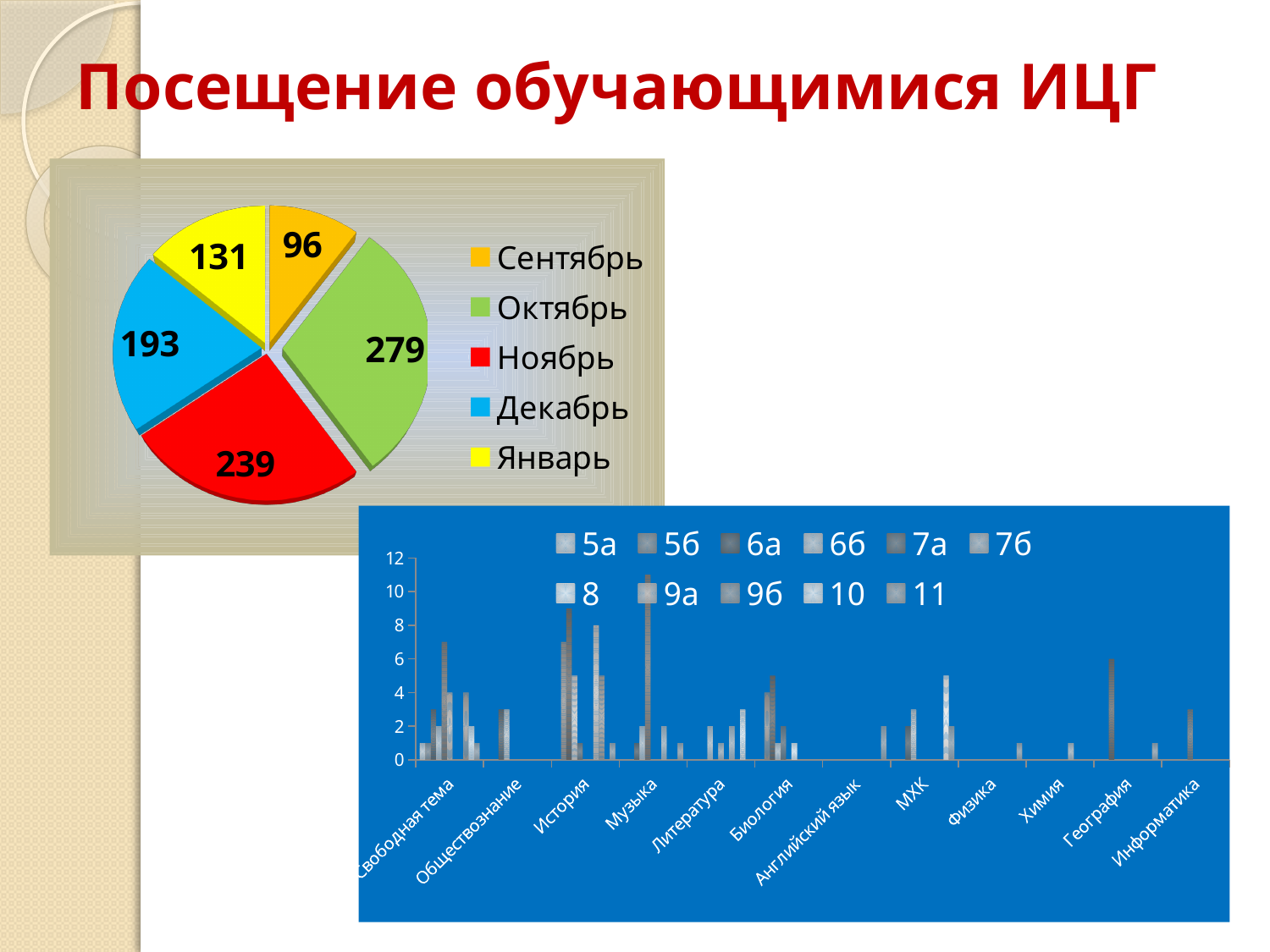
In the pie chart, how many slices are there? 5 In the pie chart, which is larger, the value for Декабрь or the value for Январь? Декабрь In the bar chart at the bottom right, how many series does the legend list? 11 In the pie chart, which month has the highest value? Октябрь In the pie chart, what is the total of all the slice values? 938 In the bar chart at the bottom right, how many subject categories are shown on the x axis? 12 In the pie chart, which colour represents Ноябрь? Red In the pie chart, what is the value for Октябрь? 279 In the pie chart, which month has the lowest value? Сентябрь In the pie chart, what is the value for Декабрь? 193 In the pie chart, what is the difference between the values for Ноябрь and Январь? 108 What kind of chart is the chart at the bottom right of the slide? Bar chart